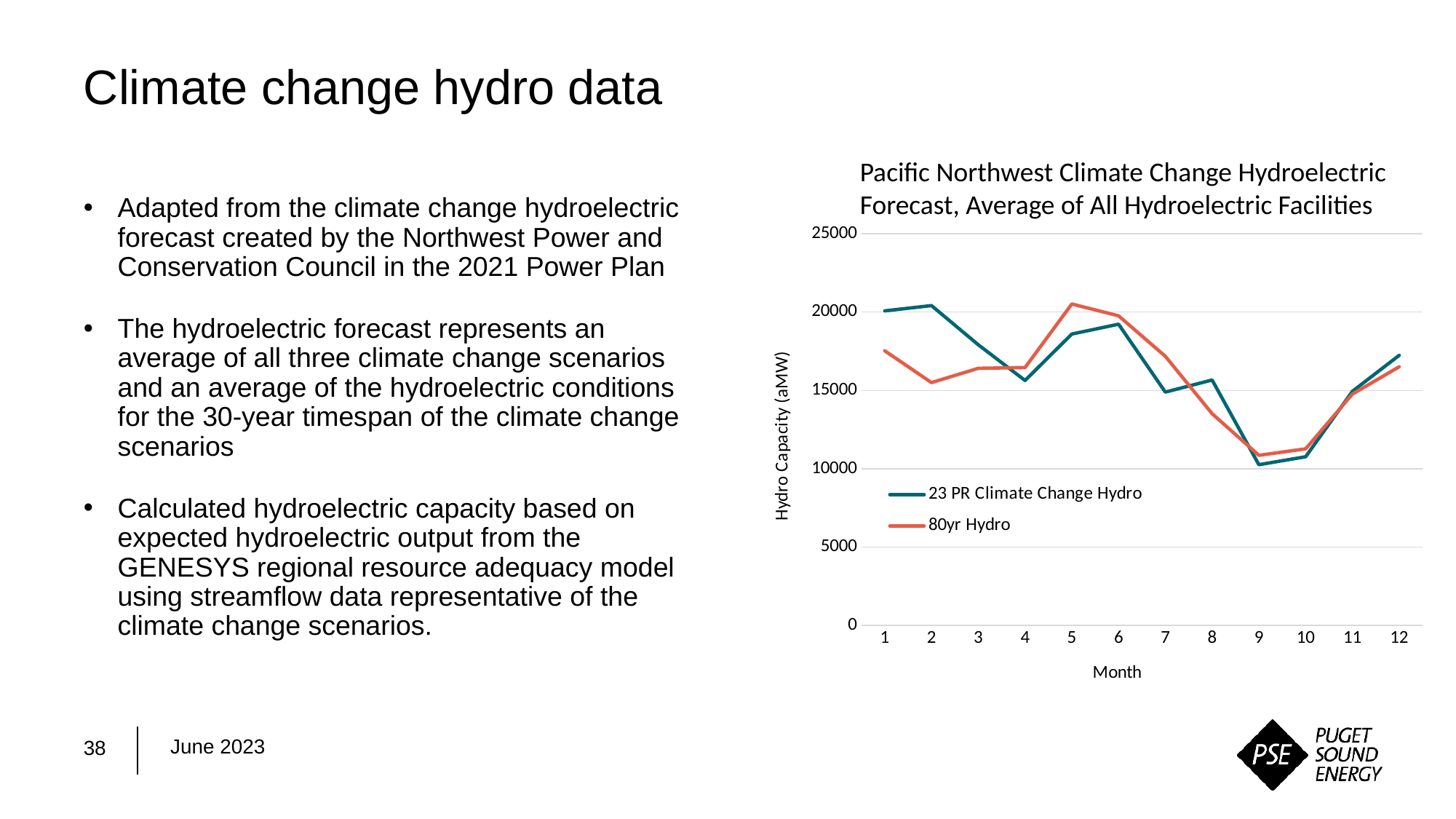
Is the value for 80yr Hydro in month 8 greater or less than 15000? less Is the value for 80yr Hydro in month 1 greater or less than 15000? greater How many months are plotted along the x axis of the chart? 12 How many series does the chart legend list? 2 What is the label of the chart's vertical axis? Hydro Capacity (aMW) Is the value for 23 PR Climate Change Hydro in month 9 greater or less than 15000? less Do the values of the 80yr Hydro series rise or fall from month 6 to month 9? fall In which month is the 80yr Hydro series at its lowest? 9 What kind of chart is shown on the slide? line chart In month 2, which series has the larger value, 23 PR Climate Change Hydro or 80yr Hydro? 23 PR Climate Change Hydro In month 5, which series has the larger value, 23 PR Climate Change Hydro or 80yr Hydro? 80yr Hydro In which month is the 23 PR Climate Change Hydro series at its lowest? 9